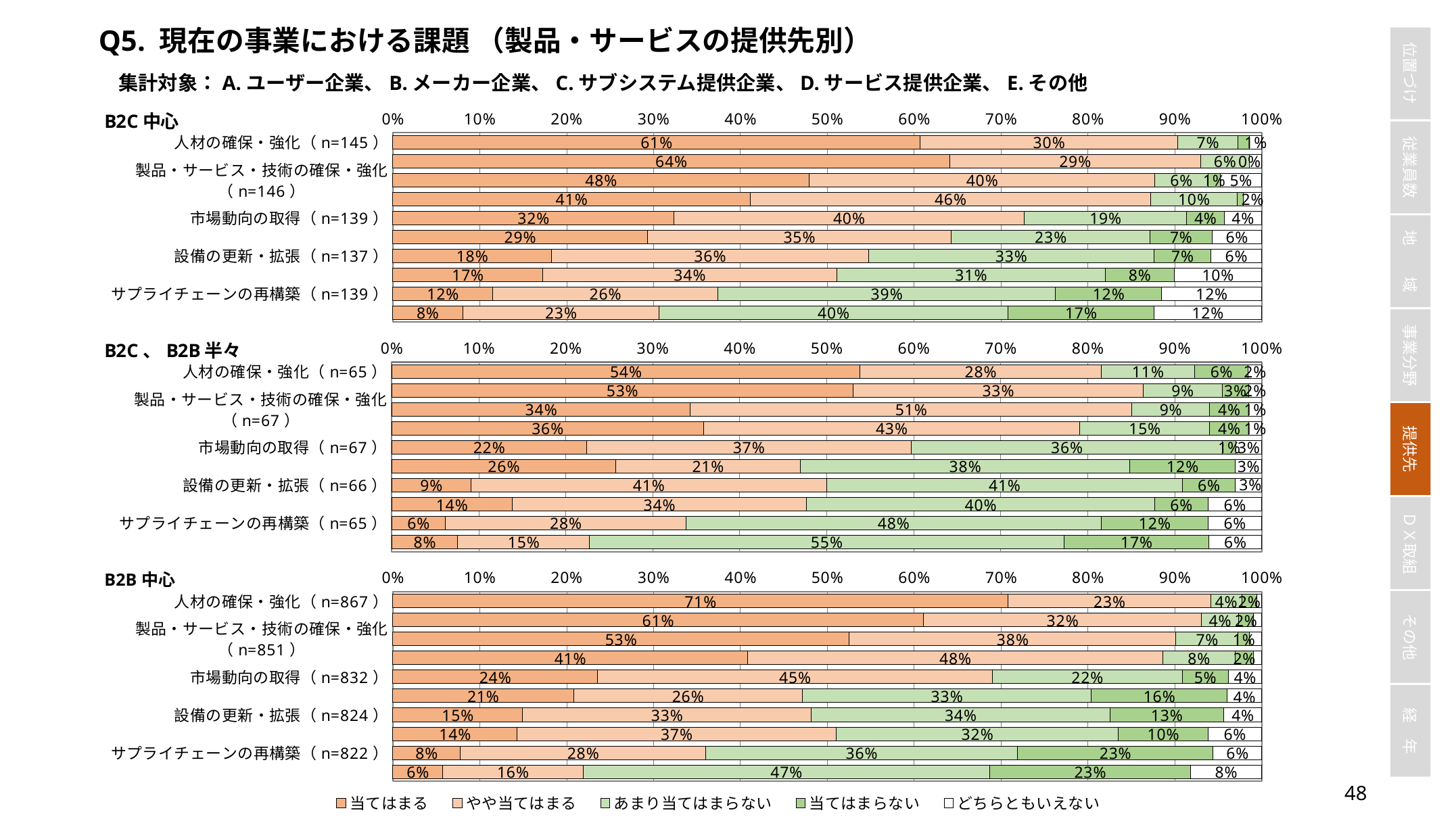
What kind of chart is used on this slide? Stacked bar chart In the B2C 中心 chart, what is the やや当てはまる value for 人材の確保・強化 (n=145)? 30% In the B2B 中心 chart, what is the 当てはまる value for 人材の確保・強化 (n=867)? 71% For 人材の確保・強化, which chart shows the larger 当てはまる share: B2C 中心 or B2B 中心? B2B 中心 In the B2C 中心 chart, what is the 当てはまる value for 人材の確保・強化 (n=145)? 61% In the B2C、B2B 半々 chart, what is the 当てはまる value for 人材の確保・強化 (n=65)? 54% In the B2C、B2B 半々 chart, what is the 当てはまる value for 市場動向の取得 (n=67)? 22% What is the first entry in the legend at the bottom of the slide? 当てはまる In the B2B 中心 chart, what is the 当てはまる value for サプライチェーンの再構築 (n=822)? 8% How many bars are plotted in the B2C 中心 chart? 10 How many series does the legend at the bottom of the slide list? 5 What is the difference between the 当てはまる value for 人材の確保・強化 in the B2B 中心 chart (71%) and in the B2C 中心 chart (61%)? 10 percentage points